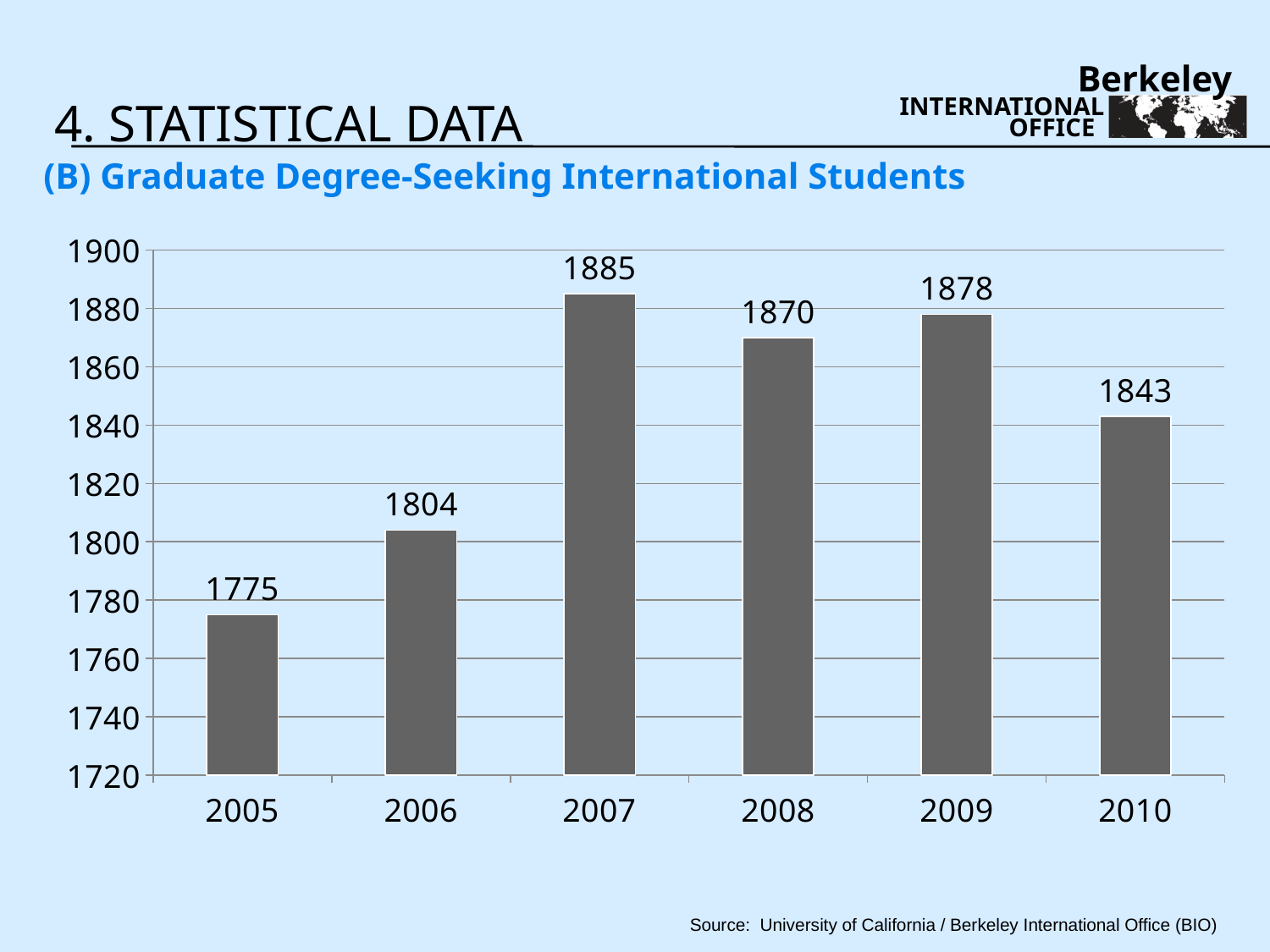
Do the values rise or fall from 2005 to 2007? rise What is the value for 2010? 1843 Is the value for 2006 greater or less than 1820? less What kind of chart is shown on the slide? bar chart What is the value for 2005? 1775 What is the value for 2007? 1885 What is the difference between the values for 2009 and 2010? 35 Which year has the lowest value? 2005 Which year has the highest value? 2007 What is the difference between the values for 2007 and 2005? 110 Which is larger, the value for 2008 or the value for 2009? 2009 How many years are shown on the x axis? 6